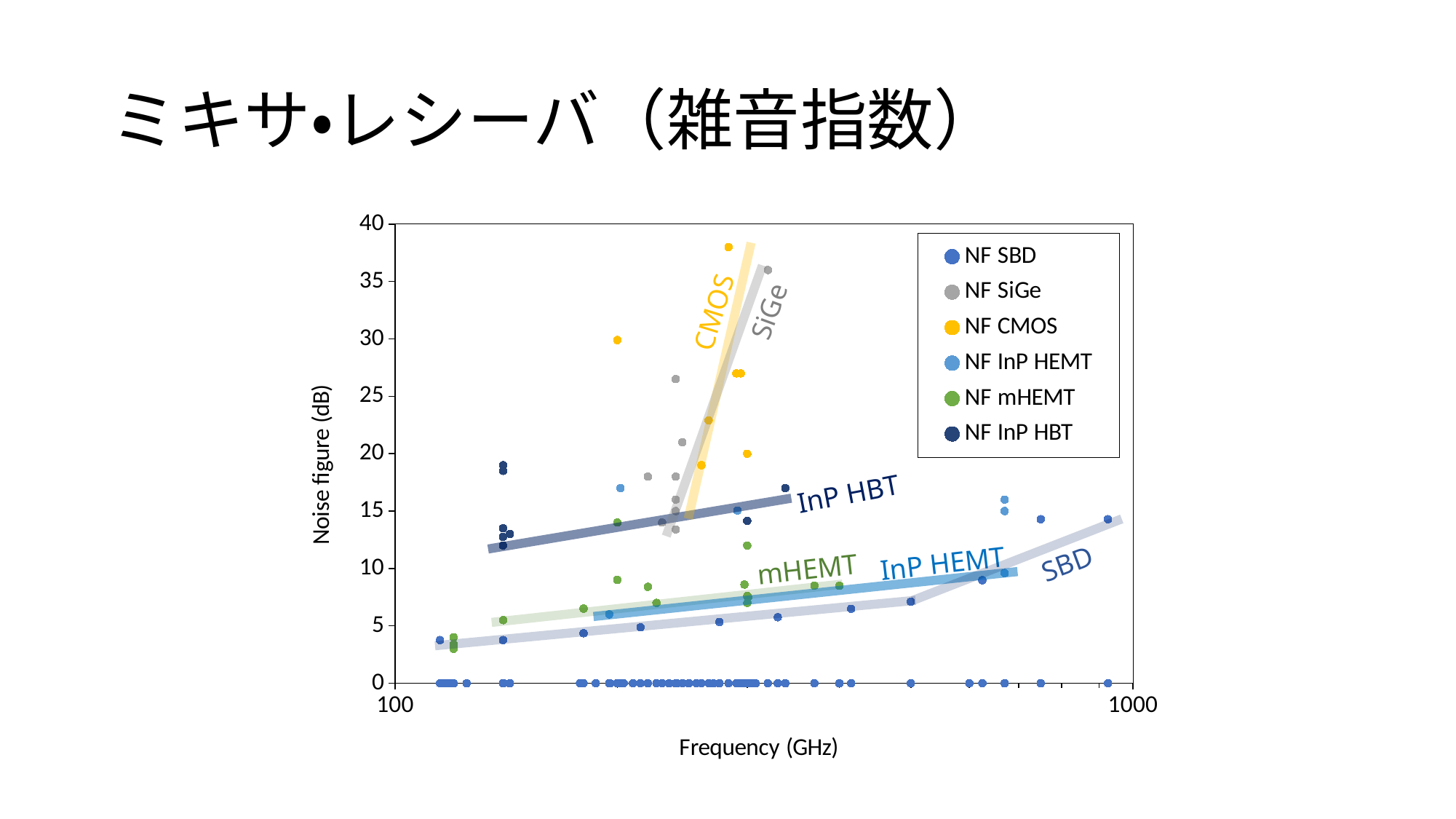
Is the highest NF InP HBT point near 150 GHz greater or less than 15 dB? greater How many series does the legend list? 6 Is the lowest NF mHEMT point greater or less than 5 dB? less Does the SBD trend line rise or fall as frequency increases? rise Which series reaches the highest noise figure value on the chart? NF CMOS What is the label of the y axis? Noise figure (dB) Is the NF SBD point near 900 GHz greater or less than 15 dB? less What kind of chart is shown on the slide? scatter chart What is the label of the x axis? Frequency (GHz) Does the CMOS trend line rise or fall as frequency increases? rise